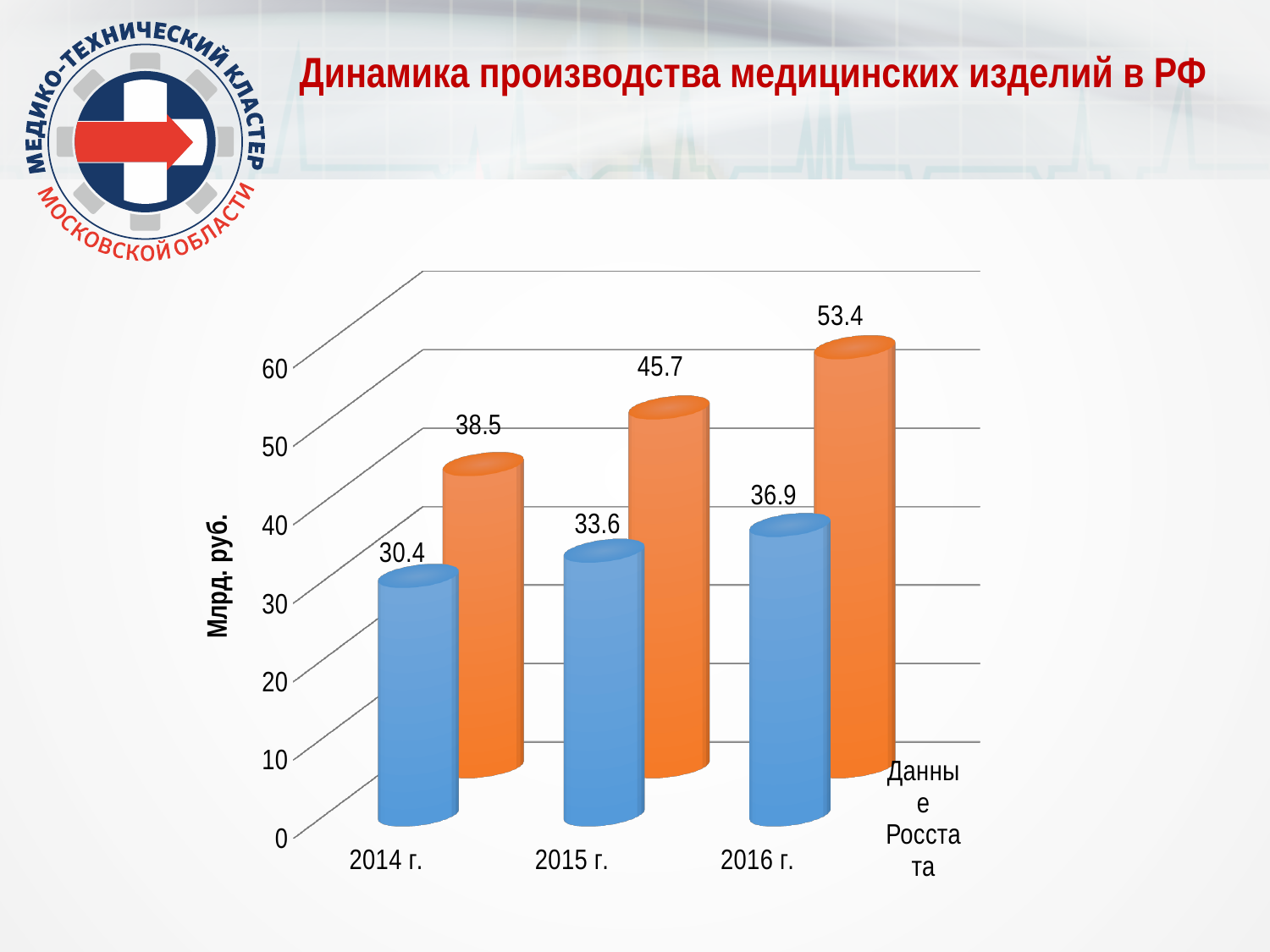
By how much did the orange bar value increase from 2014 г. to 2015 г.? 7.2 Which is larger for 2015 г., the blue bar or the orange bar? the orange bar What is the value of the blue bar for 2016 г.? 36.9 Do the blue bar values rise or fall from 2014 г. to 2016 г.? rise Which year has the lowest blue bar? 2014 г. What is the value of the orange bar for 2016 г.? 53.4 Which year has the highest orange bar? 2016 г. What is the value of the orange bar for 2015 г.? 45.7 How many years are shown on the x axis? 3 What kind of chart is shown on the slide? bar chart What is the difference between the orange and blue bars for 2016 г.? 16.5 What is the value of the blue bar for 2014 г.? 30.4